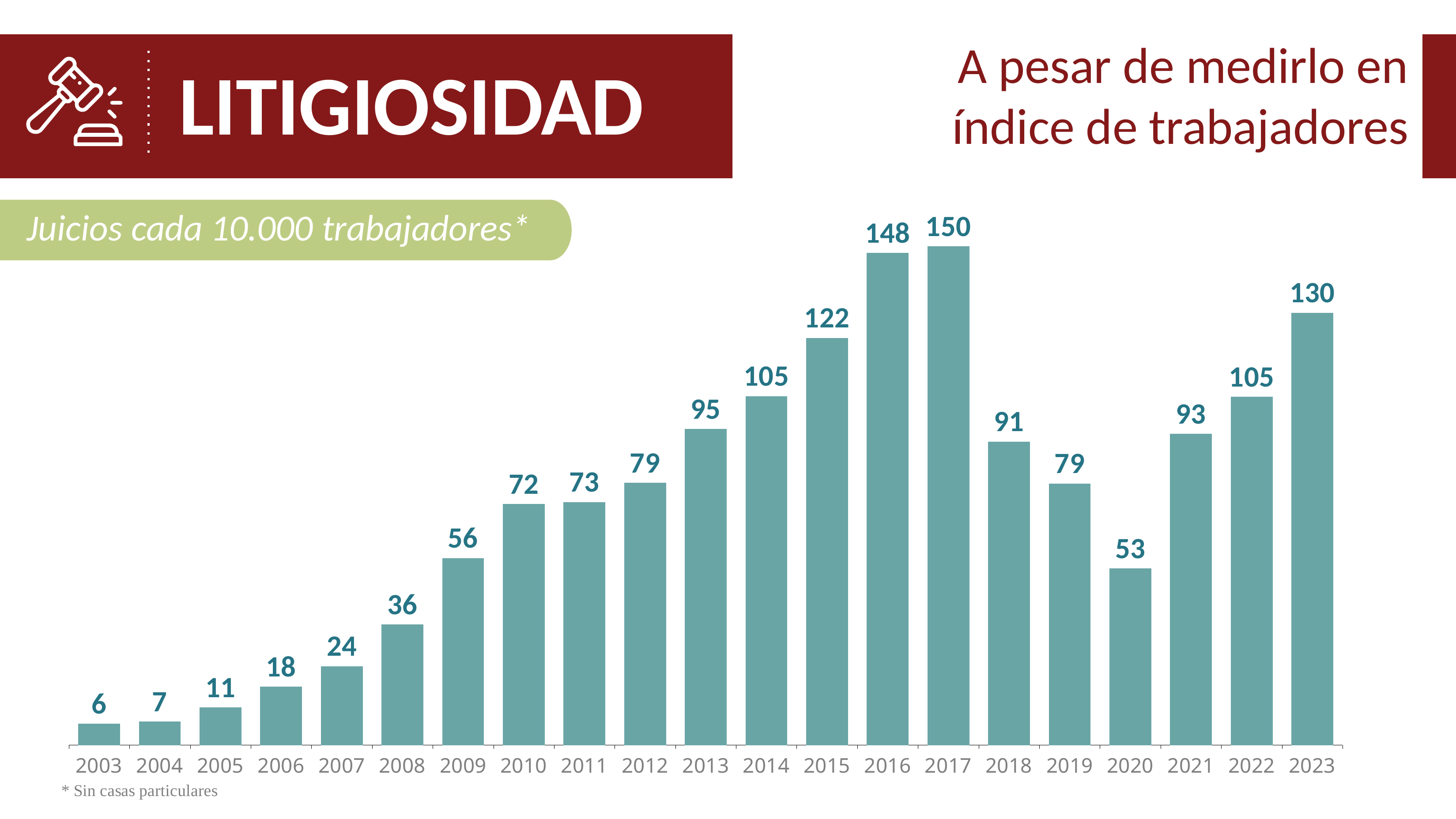
What is the difference between the values for 2023 and 2022? 25 What is the subtitle label above the chart describing the measure? Juicios cada 10.000 trabajadores* How many years are shown on the x axis? 21 What is the value for 2020? 53 Which is larger, the value for 2015 or the value for 2019? 2015 Which year has the highest value? 2017 What is the value for 2023? 130 What is the value for 2017? 150 Which year has the lowest value? 2003 What kind of chart is shown? bar chart Do the values rise or fall from 2003 to 2017? rise What is the difference between the values for 2017 and 2018? 59